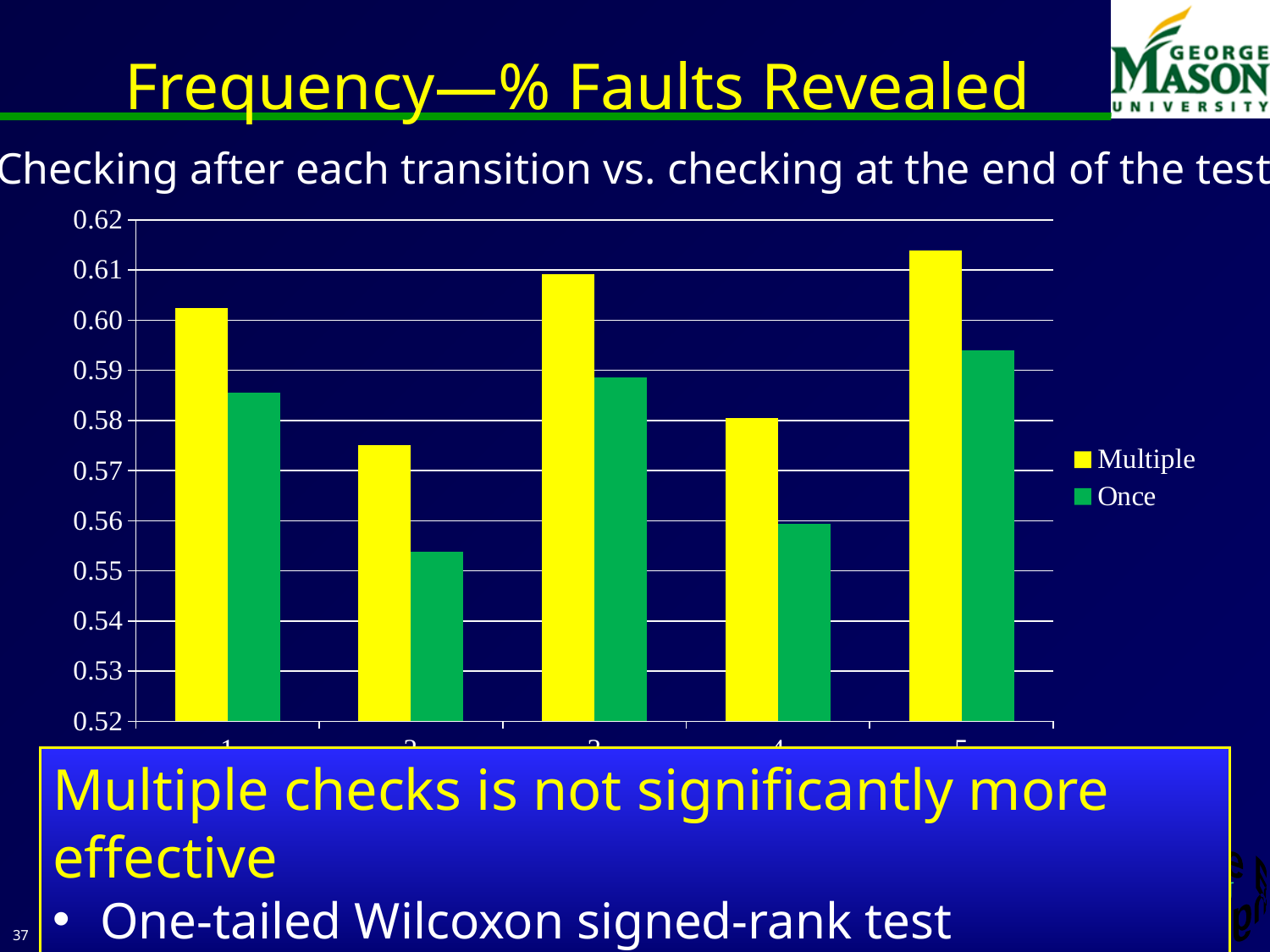
Is the Once value for category 2 greater or less than 0.56? less Is the Multiple value for category 3 greater or less than 0.60? greater How many series does the legend list? 2 For category 1, which series has the larger value, Multiple or Once? Multiple Which category has the highest value for the Once series? 5 Which category has the highest value for the Multiple series? 5 What kind of chart is shown on the slide? bar chart Which colour represents the Once series in the legend? green Which category has the lowest value for the Once series? 2 How many categories are shown along the x axis? 5 Is the Multiple value for category 4 greater or less than 0.59? less Which category has the lowest value for the Multiple series? 2